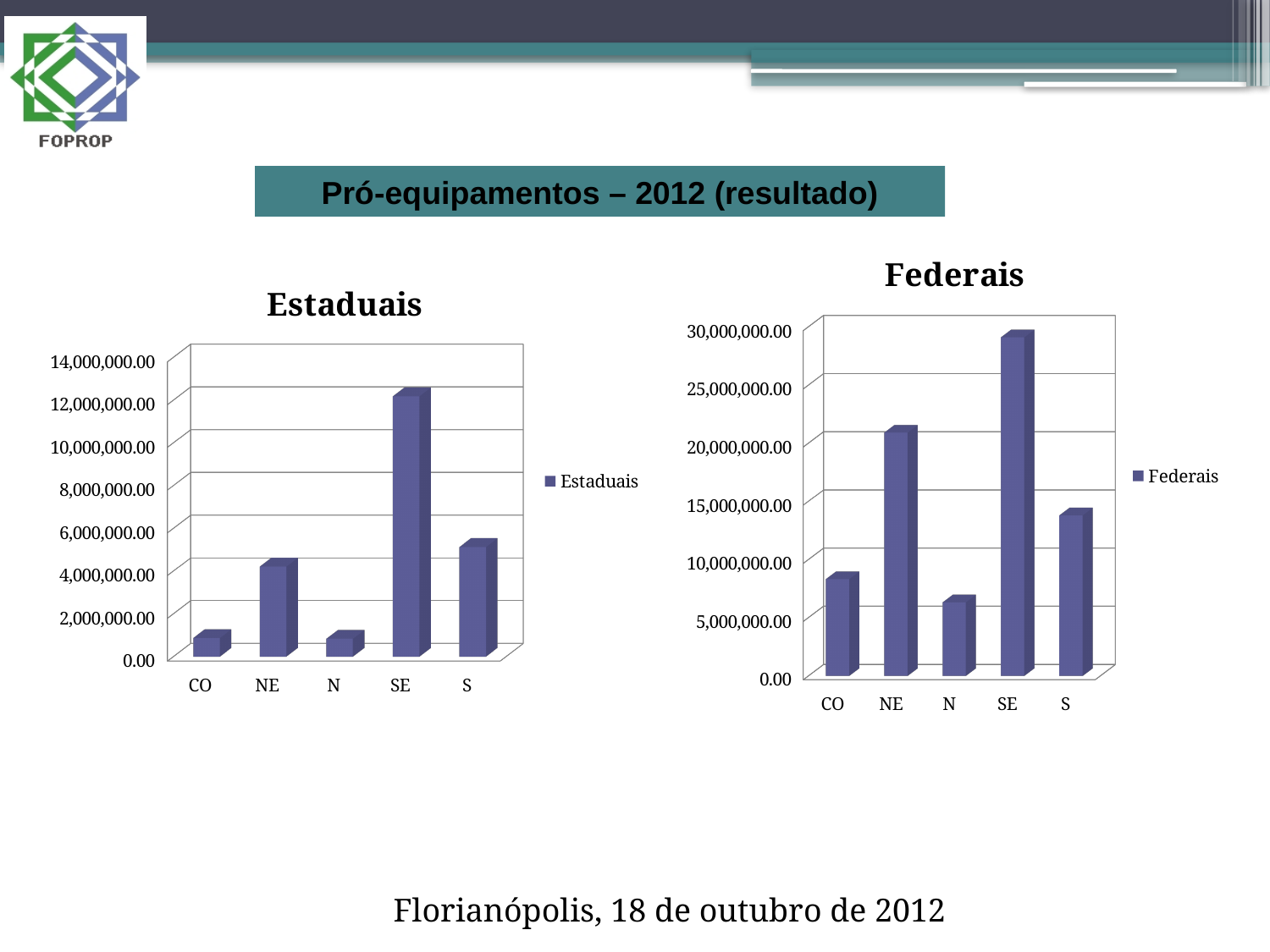
What is the title of the chart on the right side of the slide? Federais How many categories are shown on the x axis of the Federais chart? 5 In the Federais chart, which region has the lowest value? N In the Estaduais chart, which region has the highest value? SE In the Estaduais chart, which is larger, the value for S or the value for NE? S How many series does the legend of the Estaduais chart list? 1 In the Federais chart, is the value for S greater or less than 15,000,000.00? less What kind of chart is the Estaduais chart? bar chart In the Estaduais chart, is the value for SE greater or less than 10,000,000.00? greater In the Federais chart, which is larger, the value for NE or the value for S? NE In the Federais chart, which region has the highest value? SE In the Federais chart, is the value for CO greater or less than 10,000,000.00? less